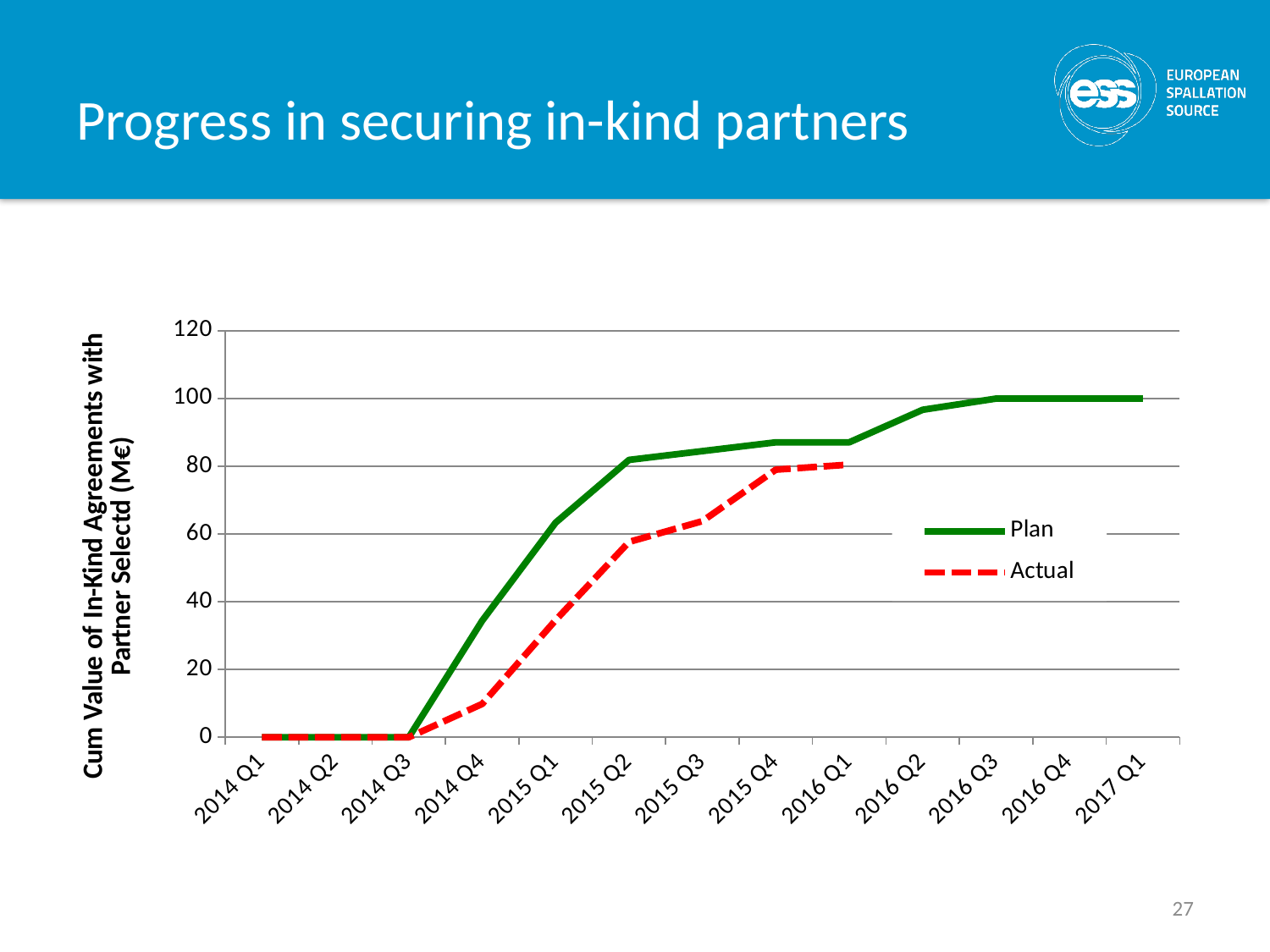
How many series does the legend list? 2 Which series is drawn as a red dashed line? Actual At 2015 Q1, which series has the larger value, Plan or Actual? Plan Is the Plan value at 2015 Q4 greater or less than 80? greater What is the Plan value at 2017 Q1? 100 What is the Plan value at 2014 Q1? 0 What kind of chart is shown on the slide? line chart How many quarters are shown on the x axis? 13 Is the Actual value at 2015 Q1 greater or less than 40? less Is the Actual value at 2015 Q2 greater or less than 60? less Does the Plan series rise or fall from 2014 Q3 to 2016 Q3? rise